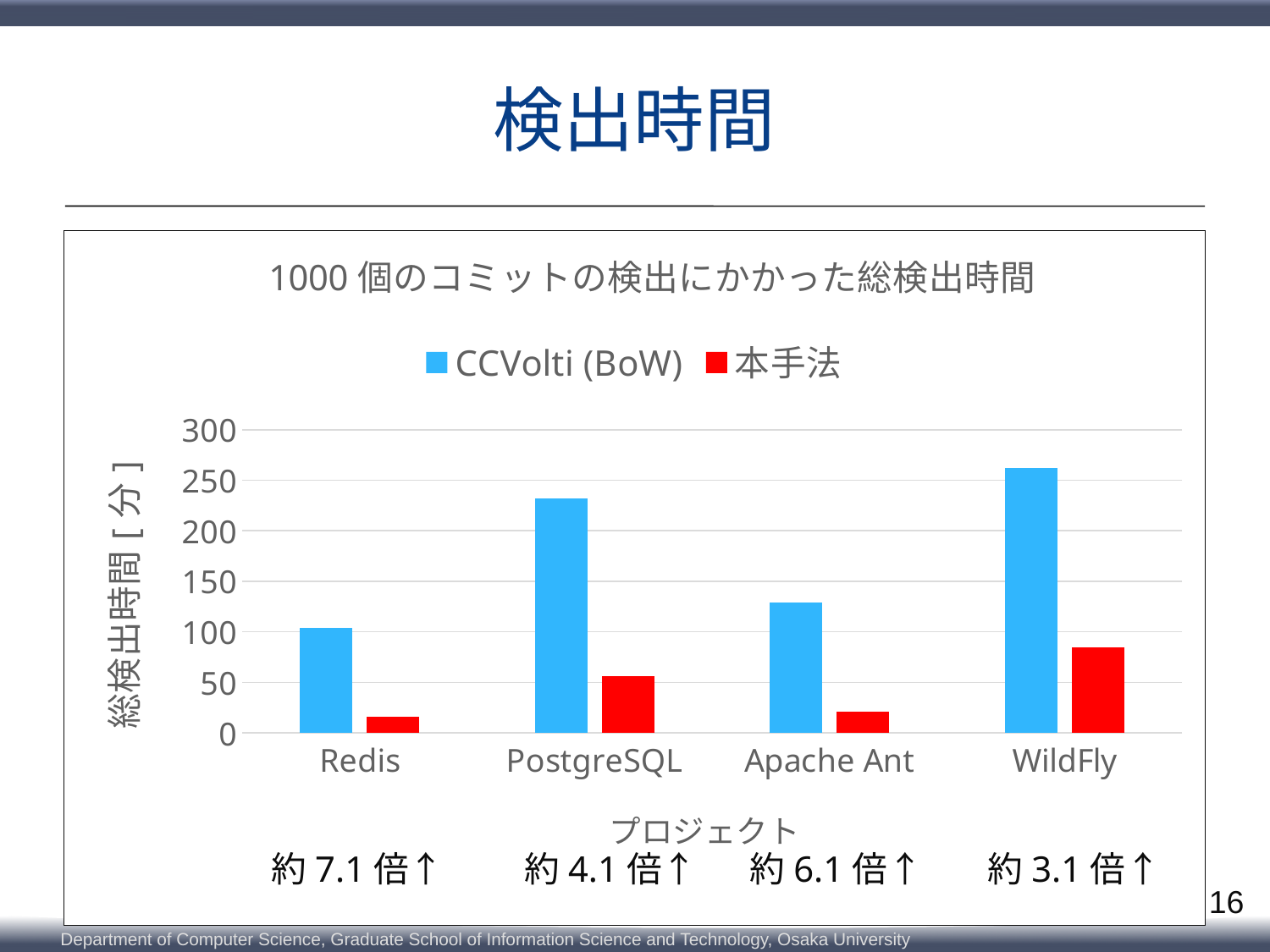
Which is larger, the CCVolti (BoW) value for PostgreSQL or for Apache Ant? PostgreSQL Is the 本手法 value for WildFly greater or less than 100? less How many projects are shown on the x axis? 4 Is the CCVolti (BoW) value for PostgreSQL greater or less than 200? greater How many series does the legend list? 2 What kind of chart is shown on the slide? bar chart Is the CCVolti (BoW) value for WildFly greater or less than 250? greater Which project has the lowest CCVolti (BoW) value? Redis What colour are the 本手法 bars? red Which project has the highest CCVolti (BoW) value? WildFly Which project has the highest 本手法 value? WildFly